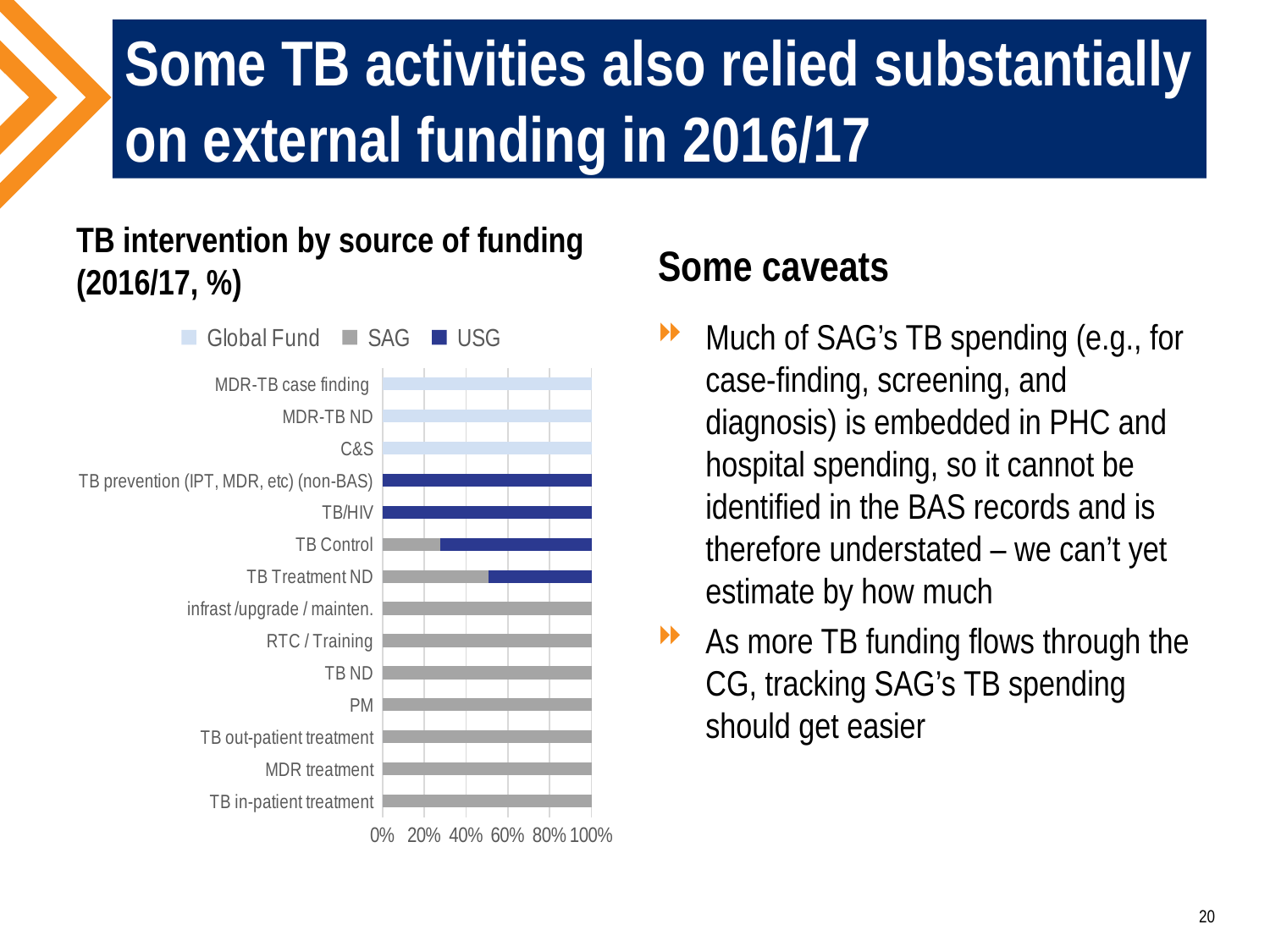
What is the title of the chart? TB intervention by source of funding (2016/17, %) What is the total of the stacked bar for PM? 100% Is the USG share for TB Control greater or less than 60%? greater Is the SAG share for TB Control greater or less than 40%? less What kind of chart is shown on the slide? Stacked bar chart Which funding source accounts for the entire bar for MDR-TB case finding? Global Fund What are the three funding sources listed in the chart legend? Global Fund, SAG, USG How many series does the chart legend list? 3 For TB Control, which is larger: the SAG share or the USG share? USG Which funding source accounts for the entire bar for TB/HIV? USG How many TB intervention categories are plotted on the chart? 14 Which funding source accounts for the entire bar for TB in-patient treatment? SAG